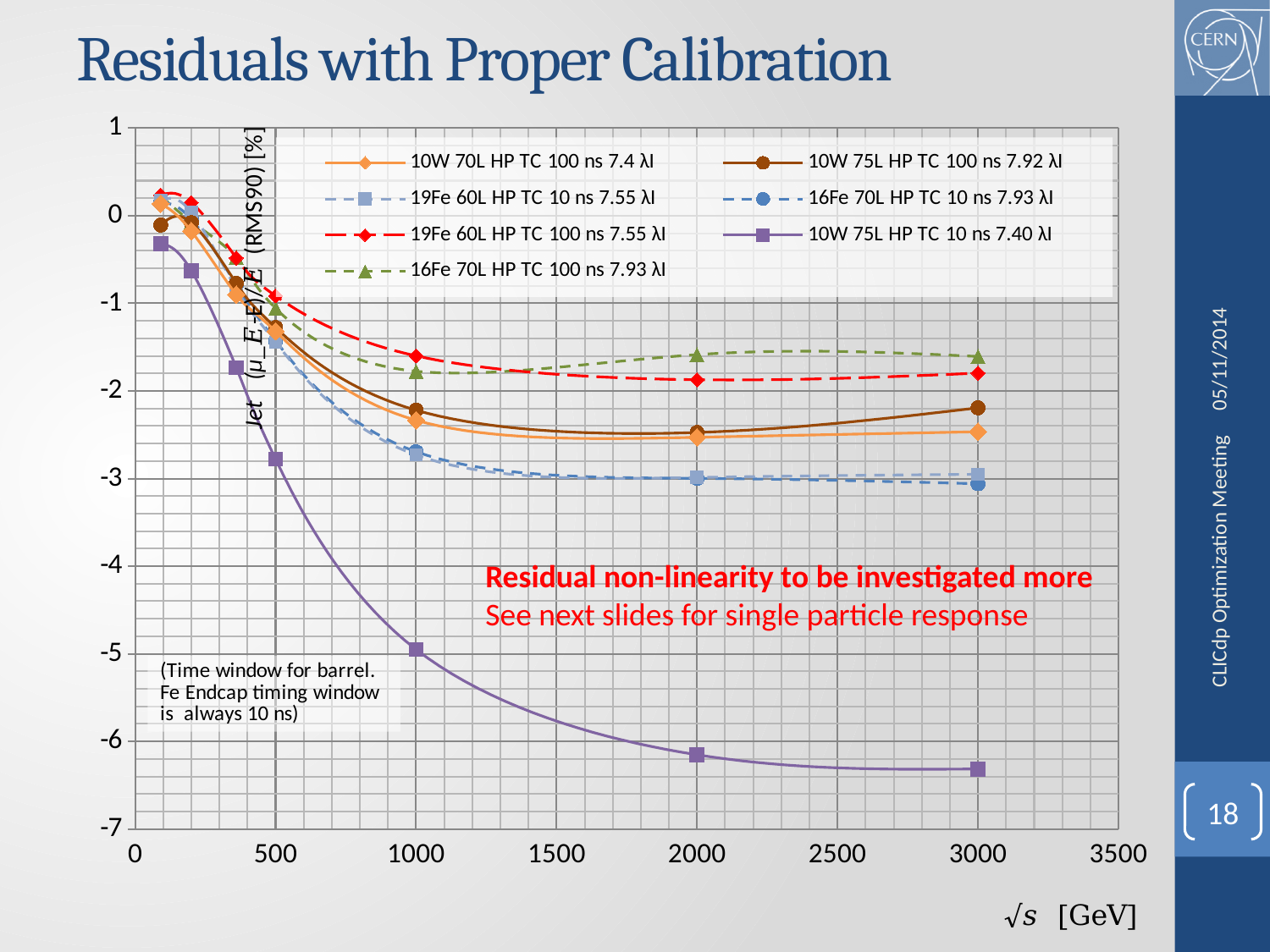
Is the value of the 16Fe 70L HP TC 100 ns 7.93 λI series at √s = 3000 GeV greater or less than -2? greater What kind of chart is shown on the slide? line chart How many series does the legend list? 7 How many data points are plotted for the 10W 75L HP TC 10 ns 7.40 λI series? 7 Is the value of the 10W 75L HP TC 10 ns 7.40 λI series at √s = 3000 GeV greater or less than -6? less Is the value of the 10W 70L HP TC 100 ns 7.4 λI series at √s = 2000 GeV greater or less than -2? less Which series has the lowest value at √s = 3000 GeV? 10W 75L HP TC 10 ns 7.40 λI What is the title of the slide's chart? Residuals with Proper Calibration At √s = 3000 GeV, which series has the higher value: 10W 75L HP TC 100 ns 7.92 λI or 10W 70L HP TC 100 ns 7.4 λI? 10W 75L HP TC 100 ns 7.92 λI Which series has the highest value at √s = 3000 GeV? 16Fe 70L HP TC 100 ns 7.93 λI Does the 10W 75L HP TC 10 ns 7.40 λI series rise or fall as √s increases from 500 to 3000 GeV? fall What is the label of the x axis? √s [GeV]